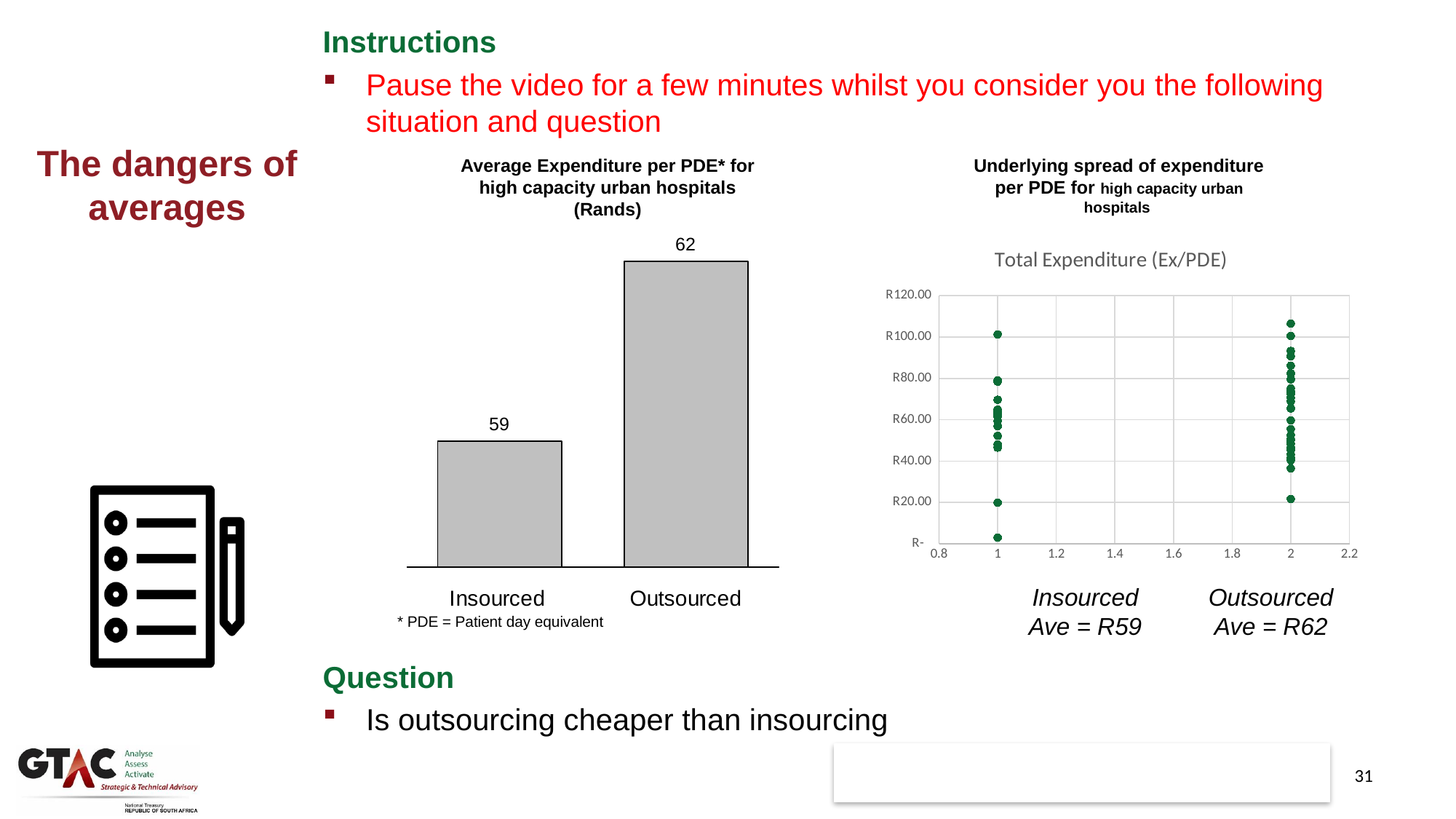
In the bar chart on the left, what is the difference between the Outsourced and Insourced values? 3 In the scatter chart on the right, is the highest Outsourced point greater or less than R100.00? greater In the bar chart on the left, which category has the lower average expenditure per PDE? Insourced What kind of chart is the chart on the left of the slide? bar chart In the scatter chart on the right, what is the highest value shown on the vertical axis? R120.00 What kind of chart is the chart on the right of the slide, titled "Total Expenditure (Ex/PDE)"? scatter chart How many categories are shown in the bar chart on the left? 2 In the bar chart titled "Average Expenditure per PDE* for high capacity urban hospitals (Rands)", what is the value for Outsourced? 62 In the bar chart on the left, which category has the higher average expenditure per PDE? Outsourced According to the text below the scatter chart on the right, what is the average for Outsourced? R62 In the bar chart titled "Average Expenditure per PDE* for high capacity urban hospitals (Rands)", what is the value for Insourced? 59 In the bar chart on the left, is the value for Insourced larger or smaller than the value for Outsourced? smaller